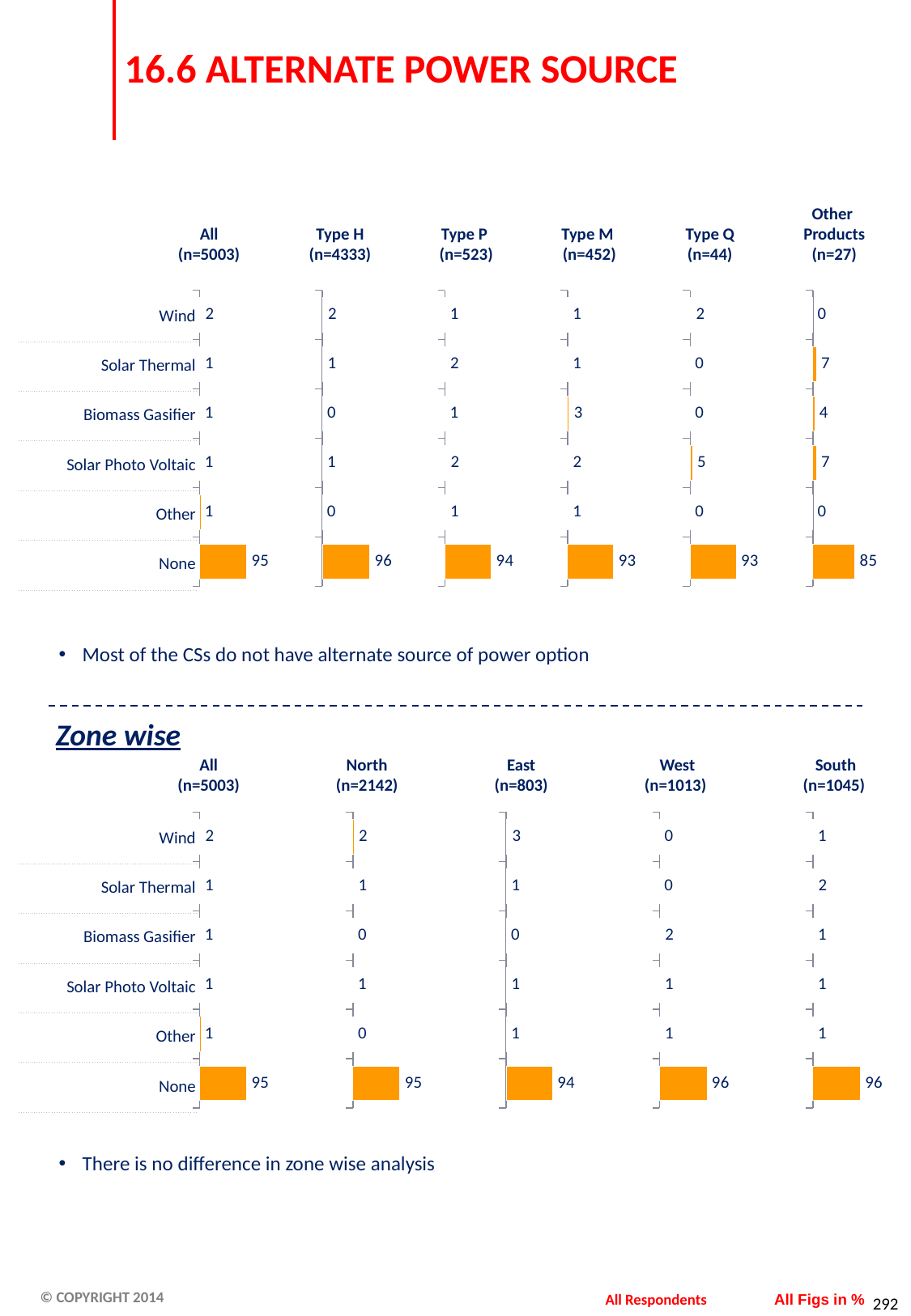
In the top section, which category has the highest value in the Other Products (n=27) chart? None In the top section, which is larger: the Biomass Gasifier value for Type M or for Type P? Type M In the top section, what is the difference between the None values in the Type H chart and the Other Products chart? 11 In the Zone wise section, what is the difference between the None values for East and South? 2 In the Zone wise section, what is the value for None in the West (n=1013) chart? 96 In the top section, what is the value for Solar Thermal in the Other Products (n=27) chart? 7 What is the sample size (n) shown for the North zone chart? n=2142 In the top section, what is the value for Solar Photo Voltaic in the Type Q (n=44) chart? 5 How many categories are listed in each chart of the Zone wise section? 6 In the top section, what is the value for None in the Type H (n=4333) chart? 96 In the Zone wise section, what is the value for Wind in the East (n=803) chart? 3 What type of chart is used to show the None values on this slide? Bar chart